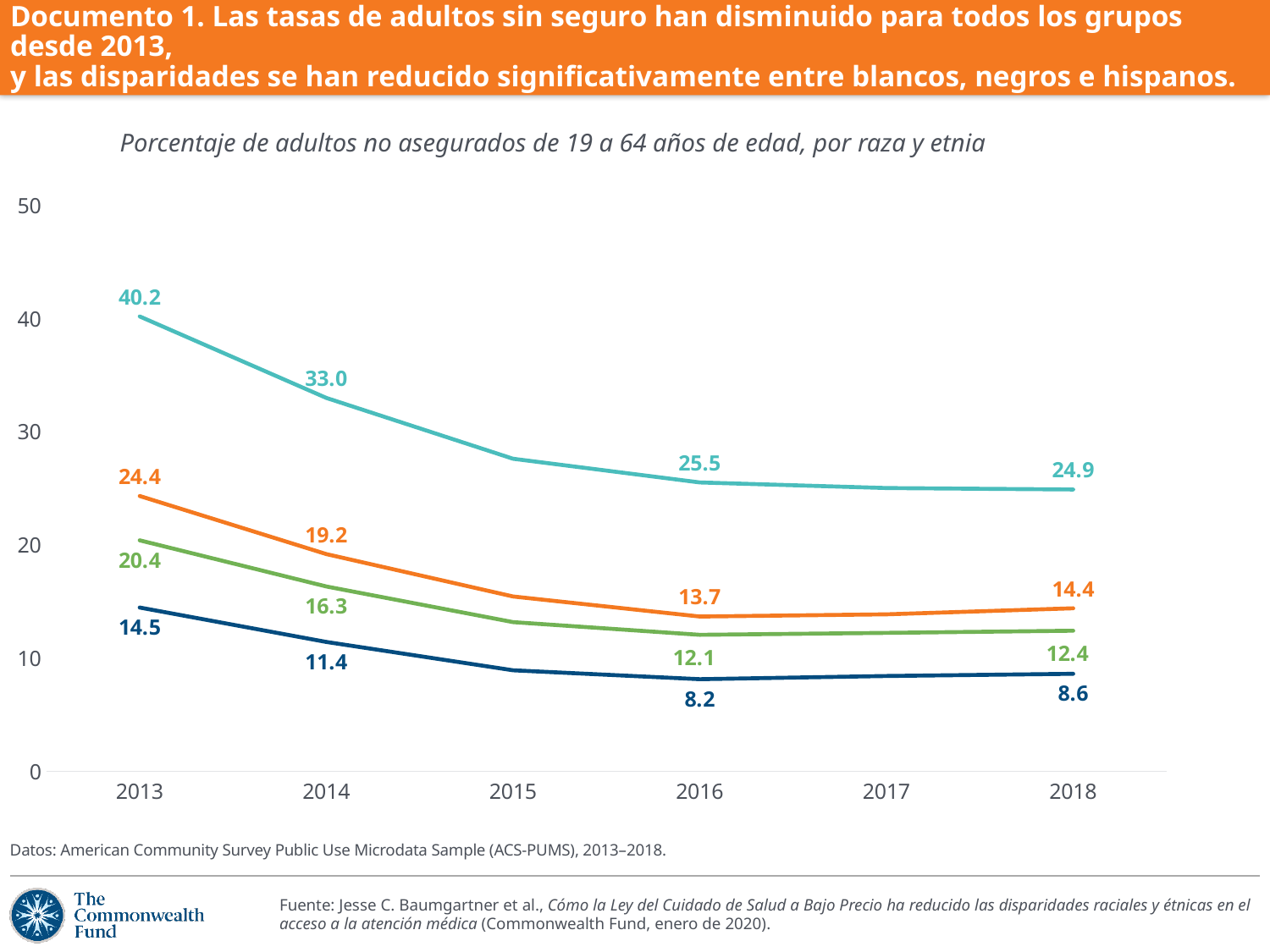
Which line has the lowest value in 2018? The dark blue line Is the value of the light blue (teal) line in 2015 greater or less than 30? less What is the difference between the orange line and the dark blue line in 2016? 5.5 By how much did the light blue (teal) line fall from 2013 to 2018? 15.3 How many years are shown on the x axis? 6 What is the value of the green line in 2018? 12.4 What type of chart is shown on the slide? Line chart What is the value of the light blue (teal) line in 2013? 40.2 Which line has the highest value in 2013? The light blue (teal) line Does the dark blue line rise or fall from 2013 to 2016? Fall What is the value of the orange line in 2016? 13.7 What is the value of the dark blue line in 2014? 11.4